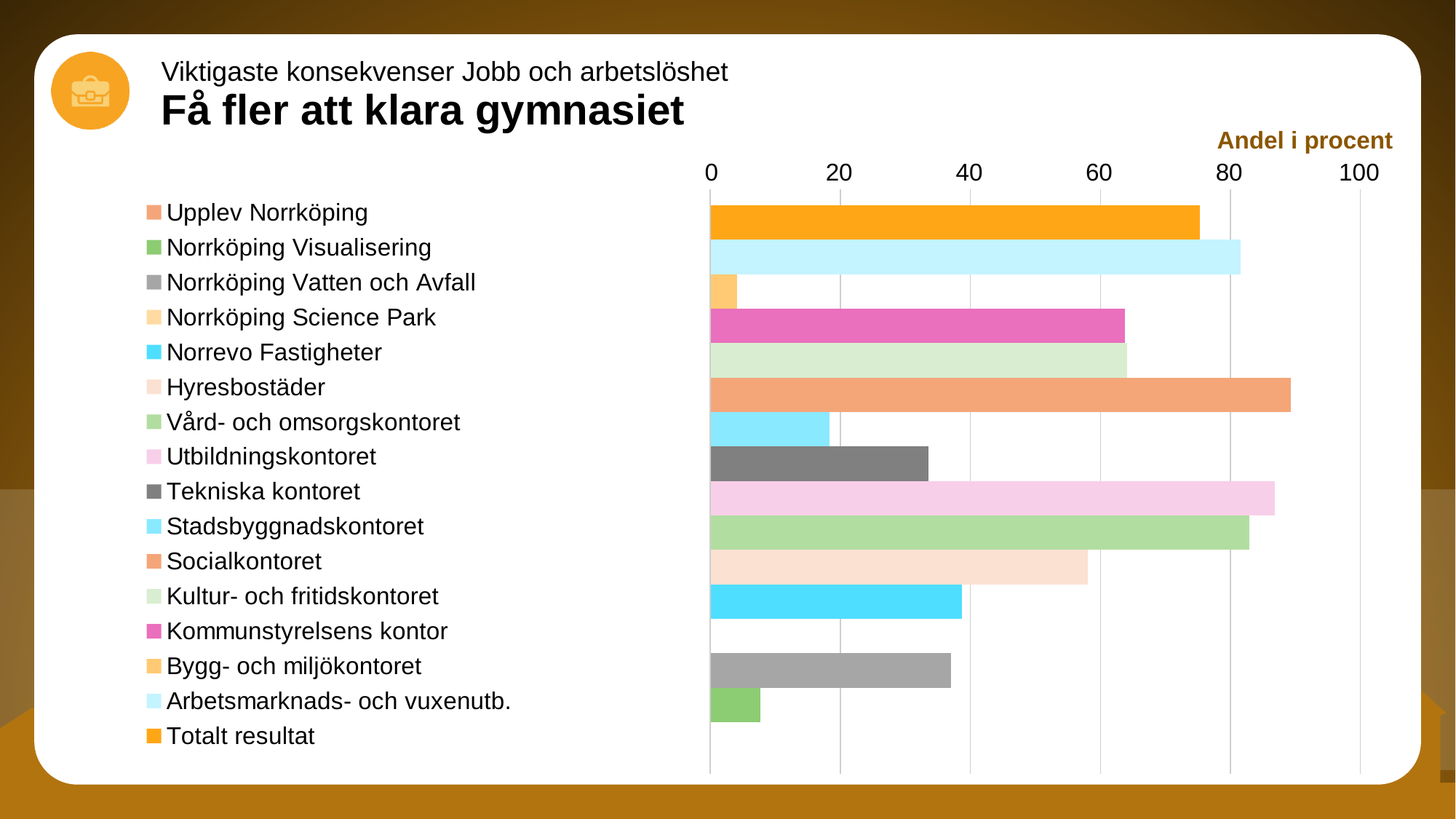
How many entries does the legend list? 16 Is the value for Norrköping Visualisering greater or less than 20? less Is the value for Tekniska kontoret greater or less than 40? less Is the value for Stadsbyggnadskontoret greater or less than 40? less What kind of chart is shown on the slide? bar chart Which has the larger value, Totalt resultat or Tekniska kontoret? Totalt resultat Which has the larger value, Socialkontoret or Stadsbyggnadskontoret? Socialkontoret What is the label shown above the horizontal axis? Andel i procent